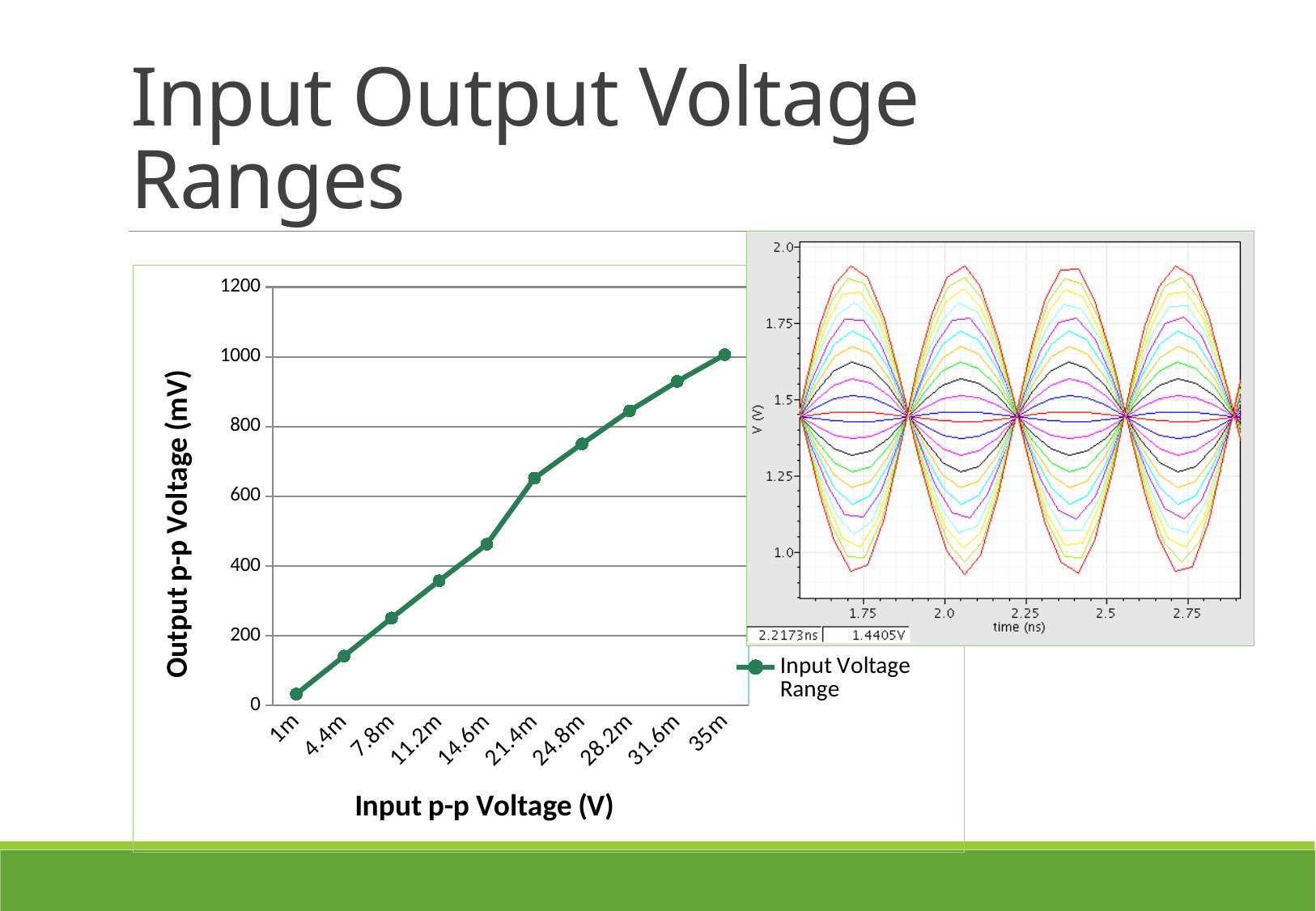
In the line chart on the left, which input p-p voltage has the highest output p-p voltage? 35m In the line chart on the left, how many series does the legend list? 1 In the line chart on the left, what is the title of the y axis? Output p-p Voltage (mV) In the line chart on the left, is the output p-p voltage for 14.6m greater or less than 400? greater In the line chart on the left, which has the larger output p-p voltage, 11.2m or 28.2m? 28.2m In the line chart on the left, is the output p-p voltage for 1m greater or less than 200? less In the line chart on the left, which input p-p voltage has the lowest output p-p voltage? 1m In the line chart on the left, is the output p-p voltage for 35m greater or less than 800? greater In the line chart on the left, how many data points are plotted along the x axis? 10 In the line chart on the left, do the output p-p voltage values rise or fall as the input p-p voltage increases along the x axis? rise What kind of chart is the chart on the left of the slide? line chart